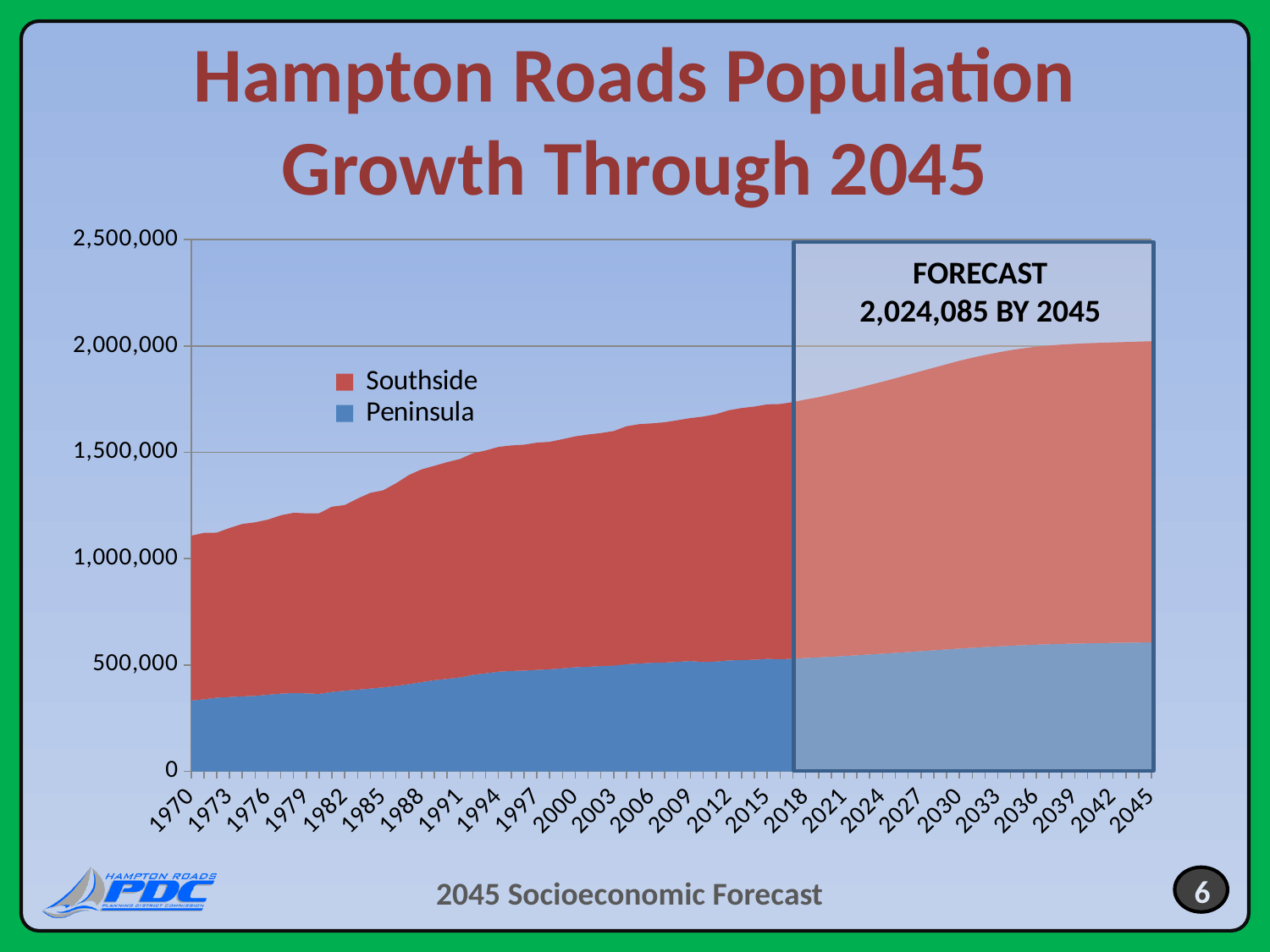
Is the total population in 2018 greater or less than 1,500,000? greater What kind of chart is shown on the slide? Area chart What forecast population value is printed for 2045? 2,024,085 In which year does the shaded forecast region begin? 2018 Is the total population in 1970 greater or less than 1,000,000? greater Is the Peninsula value in 1970 greater or less than 500,000? less How many series does the legend list? 2 What are the two series named in the legend? Southside and Peninsula Does the total population rise or fall from 1970 to 2045? Rise Which series is larger in 2045, Southside or Peninsula? Southside What is the first year shown on the x axis? 1970